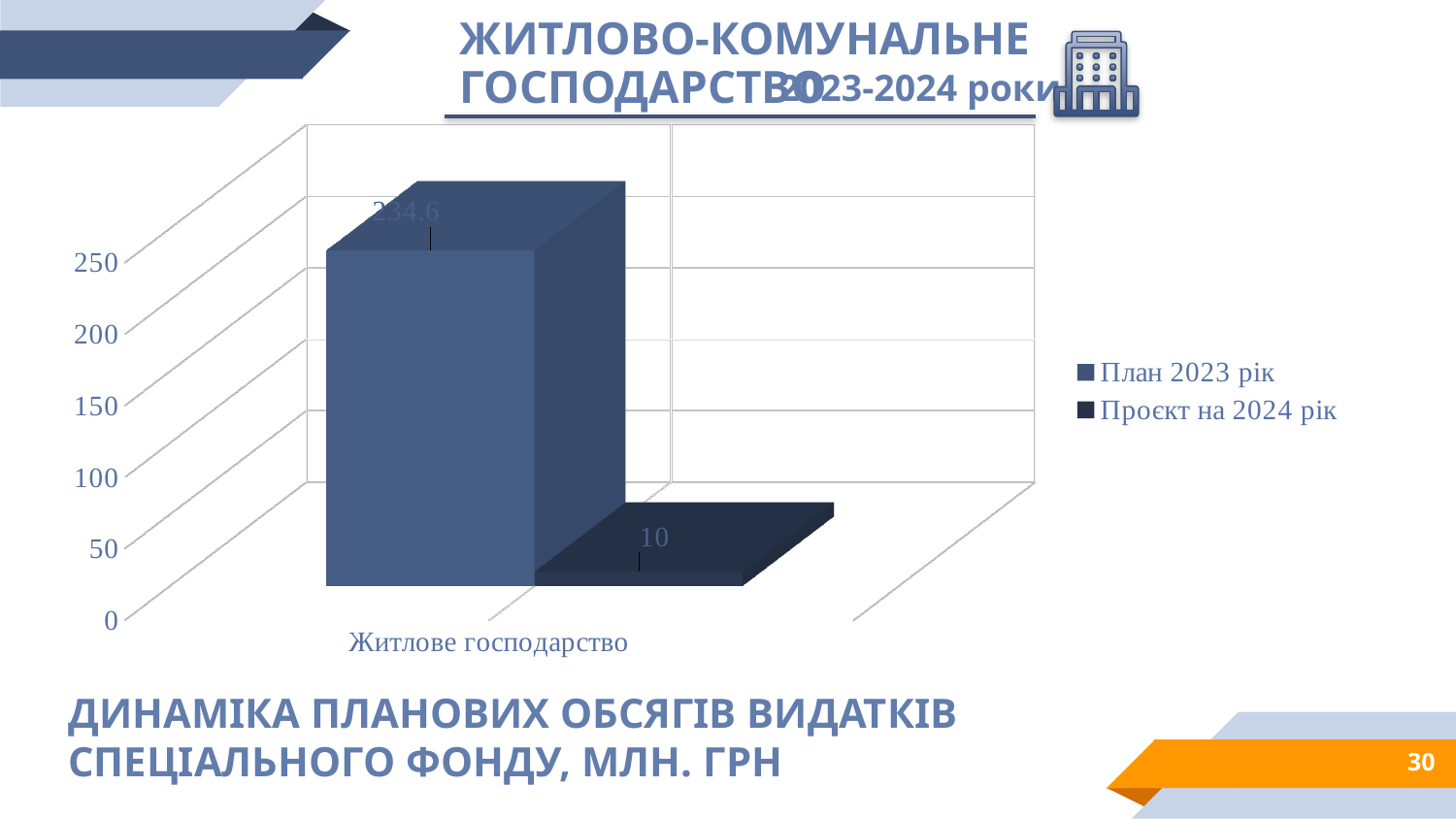
What kind of chart is shown on the slide? Bar chart Which series has the higher value for Житлове господарство, План 2023 рік or Проєкт на 2024 рік? План 2023 рік How many series does the legend list? 2 What is the highest value shown on the vertical axis? 250 What is the value for Проєкт на 2024 рік for Житлове господарство? 10 Is the value for План 2023 рік greater or less than 200? greater How many categories are shown on the x axis? 1 Is the value for Проєкт на 2024 рік greater or less than 50? less What is the category label shown on the x axis? Житлове господарство What is the value for План 2023 рік for Житлове господарство? 234.6 Which series has the lowest value on the chart? Проєкт на 2024 рік What is the difference between the План 2023 рік value and the Проєкт на 2024 рік value? 224.6